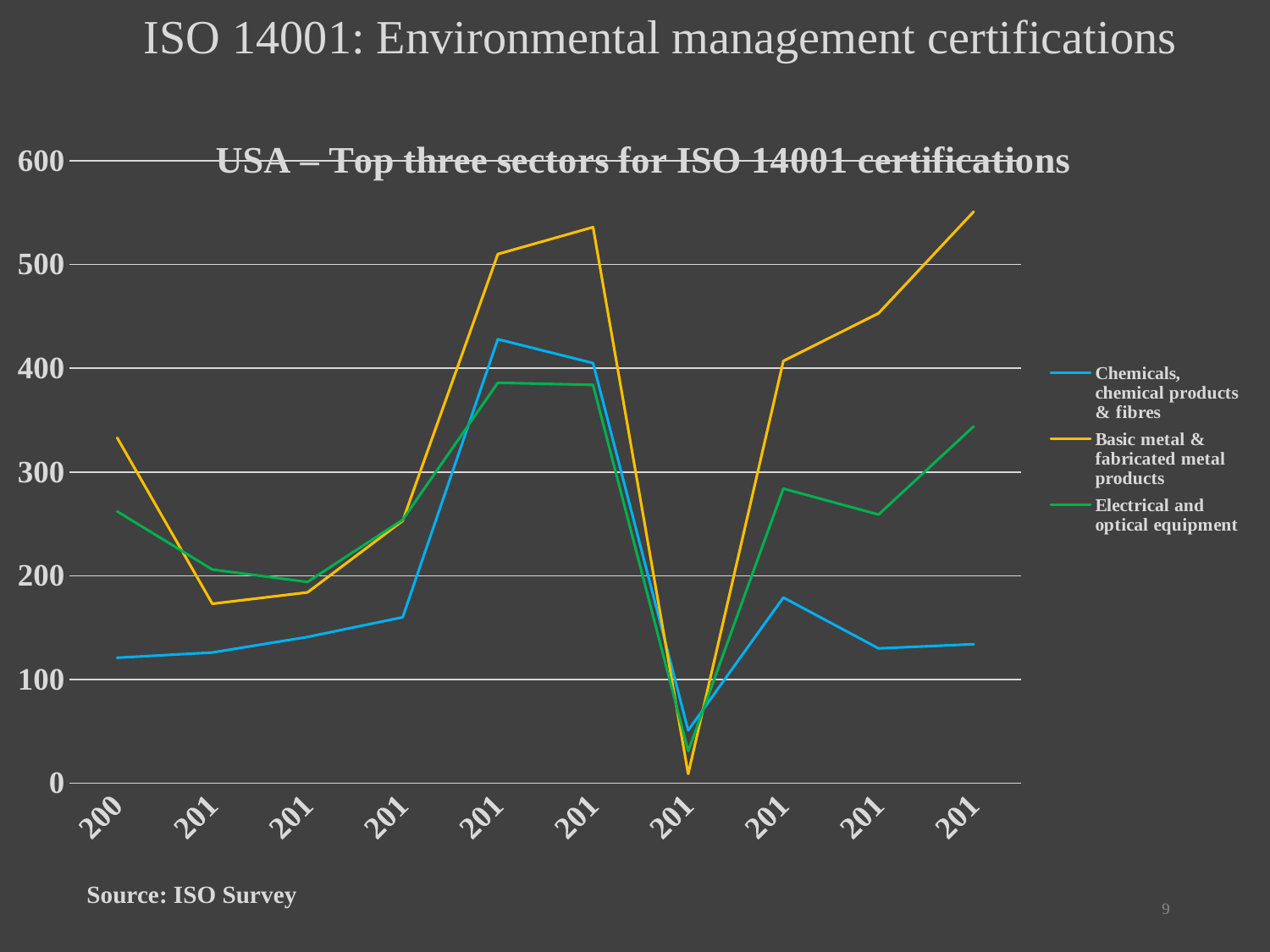
At the first point on the x axis, which is larger: Basic metal & fabricated metal products or Chemicals, chemical products & fibres? Basic metal & fabricated metal products How many data points does each line have along the x axis? 10 Is the value for Basic metal & fabricated metal products at the seventh point greater or less than 100? less Is the value for Electrical and optical equipment at the last point greater or less than 300? greater Which series has the highest value at the last point on the x axis? Basic metal & fabricated metal products Is the value for Chemicals, chemical products & fibres at the first point greater or less than 200? less How many series does the legend list? 3 What kind of chart is shown on the slide? line chart What is the title of the chart? USA – Top three sectors for ISO 14001 certifications Which colour is the line for Basic metal & fabricated metal products? yellow Which series has the lowest value at the last point on the x axis? Chemicals, chemical products & fibres